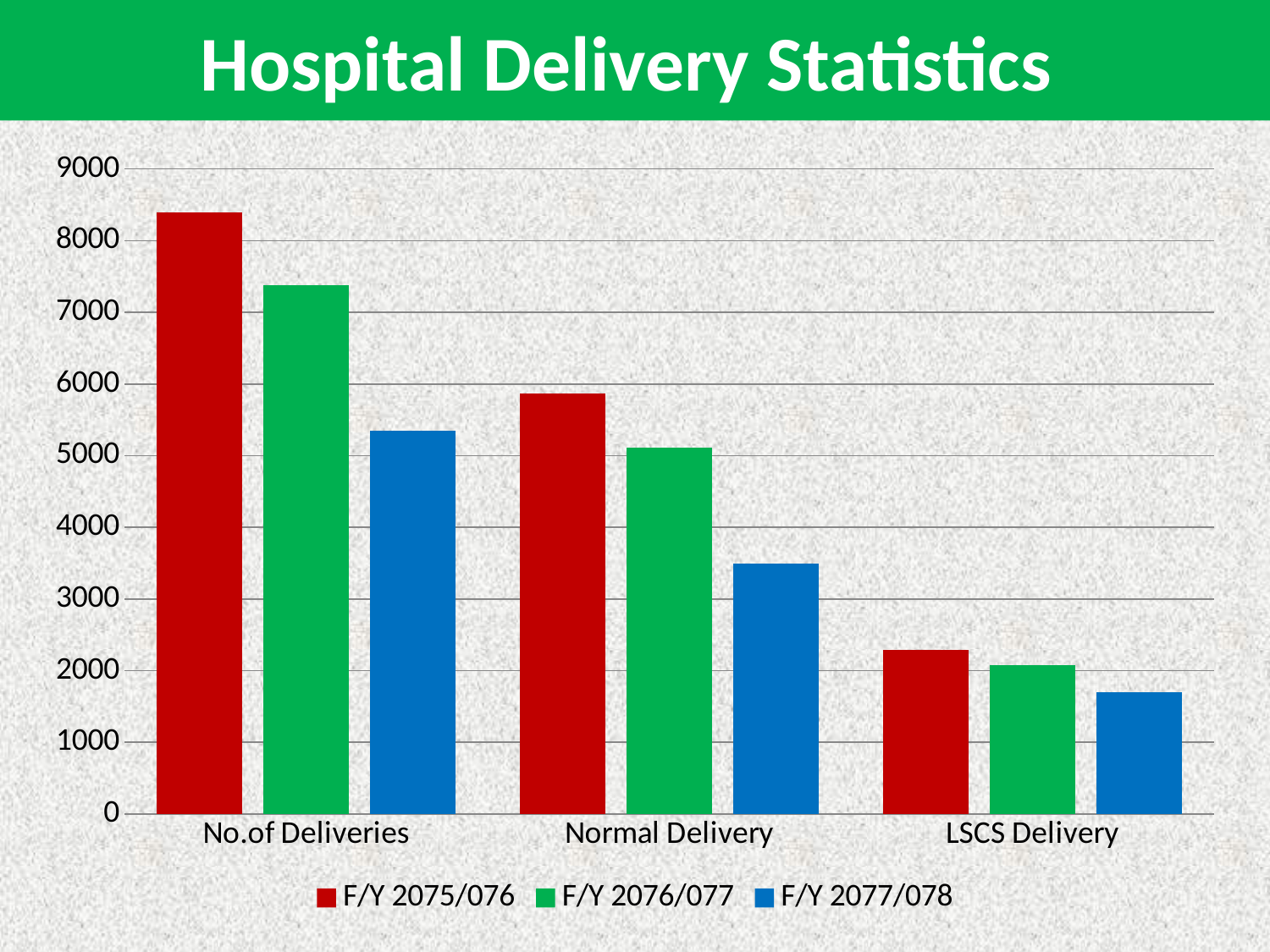
How many series does the legend list? 3 For Normal Delivery, which is larger: F/Y 2076/077 or F/Y 2077/078? F/Y 2076/077 How many categories are shown on the x axis? 3 Within the No.of Deliveries category, do the values rise or fall from F/Y 2075/076 to F/Y 2077/078? fall Which category has the highest value for F/Y 2075/076? No.of Deliveries Is the value for No.of Deliveries in F/Y 2075/076 greater or less than 8000? greater Which category has the lowest value for F/Y 2077/078? LSCS Delivery Is the value for No.of Deliveries in F/Y 2077/078 greater or less than 5000? greater What kind of chart is shown on the slide? Bar chart Is the value for LSCS Delivery in F/Y 2077/078 greater or less than 2000? less What is the title of the chart? Hospital Delivery Statistics